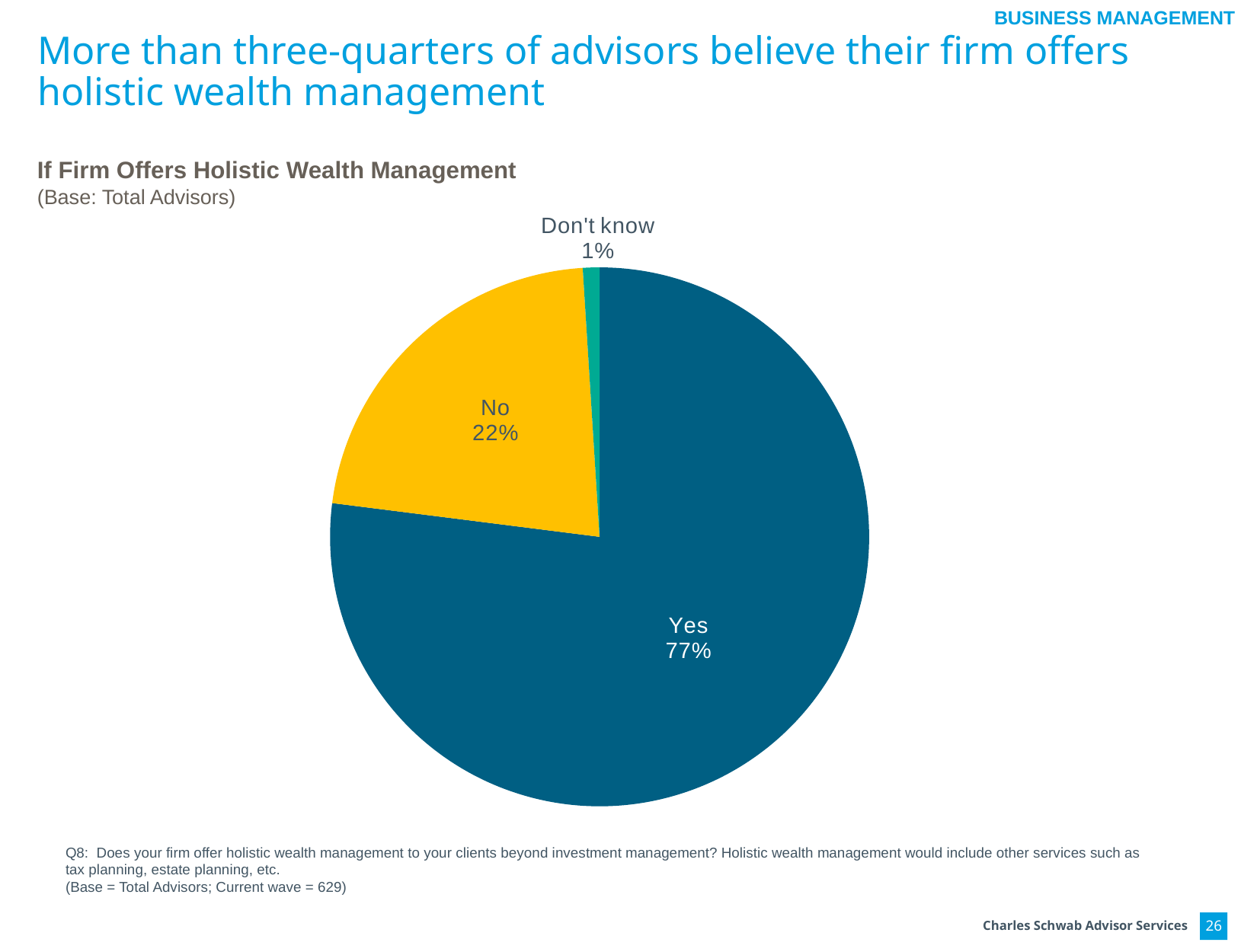
How many slices does the pie chart have? 3 What percentage of advisors answered Yes? 77% Which response has the largest share of the pie? Yes What is the title of the chart? If Firm Offers Holistic Wealth Management What kind of chart is shown on the slide? Pie chart What percentage of advisors answered Don't know? 1% What percentage of advisors answered No? 22% What colour is the Yes slice? Dark blue What share of the pie does the No slice represent? 22% Which slice is larger, No or Don't know? No Which response has the smallest share of the pie? Don't know What is the difference in percentage points between the Yes and No slices? 55